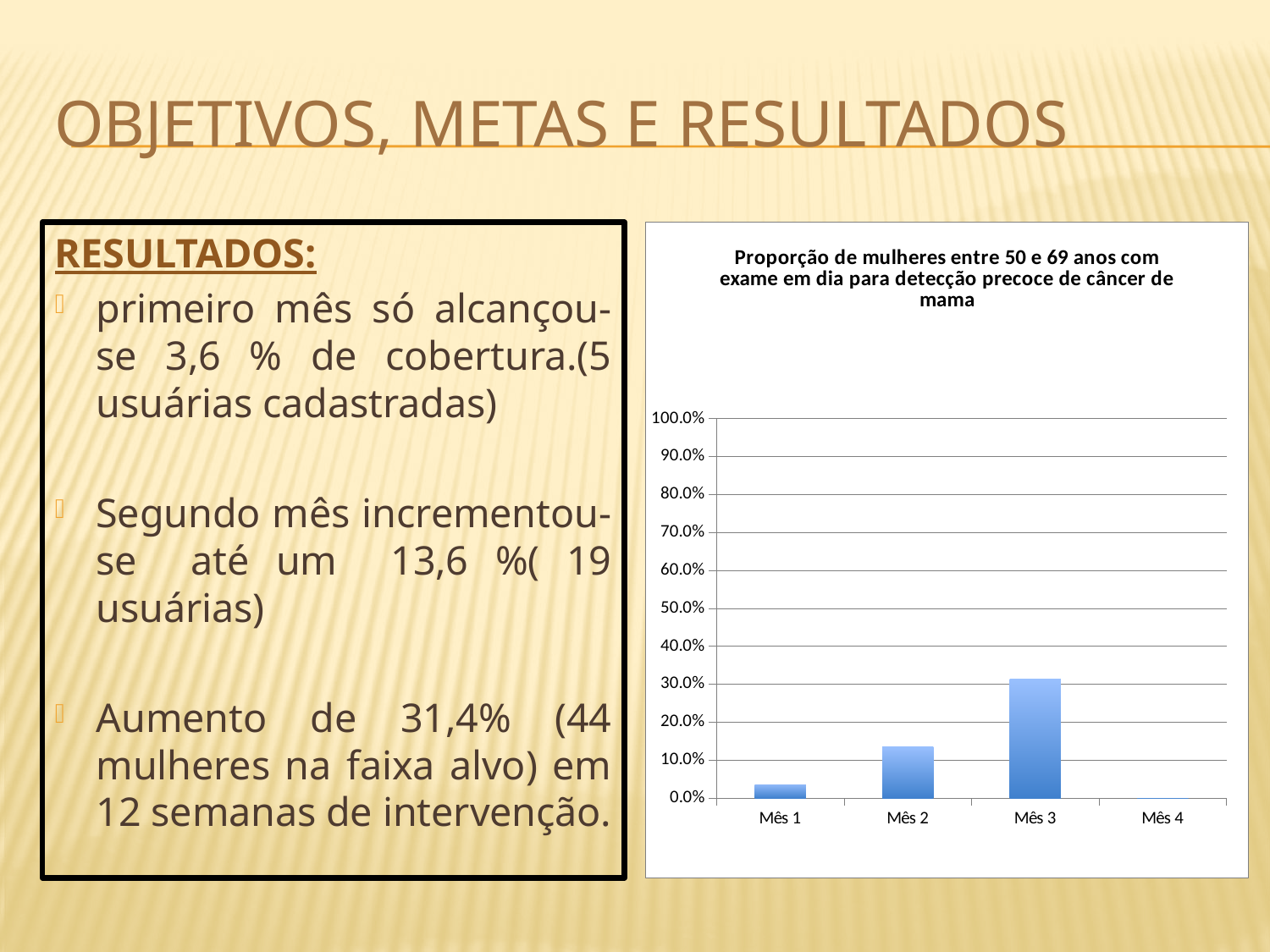
Is the value for Mês 1 greater or less than 10.0%? less Which is larger, the value for Mês 2 or the value for Mês 3? Mês 3 Is the value for Mês 3 greater or less than 20.0%? greater Is the value for Mês 2 greater or less than 20.0%? less Do the values rise or fall from Mês 1 to Mês 3? rise How many categories are shown on the x axis of the chart? 4 What is the title of the chart? Proporção de mulheres entre 50 e 69 anos com exame em dia para detecção precoce de câncer de mama What kind of chart is shown on the slide? bar chart Among Mês 1, Mês 2 and Mês 3, which has the lowest value? Mês 1 Which month has the highest value in the chart? Mês 3